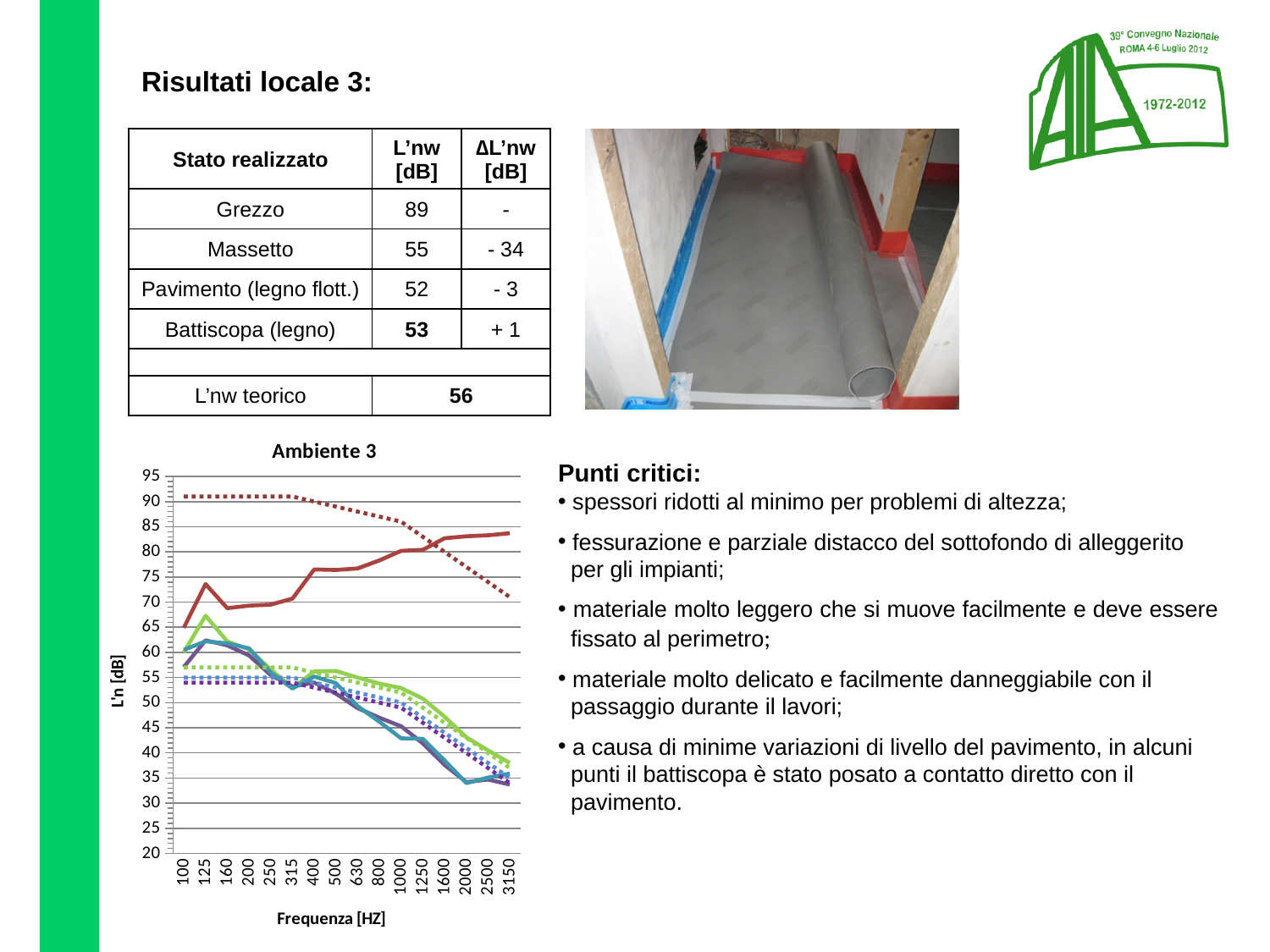
What is the label of the x axis of the chart? Frequenza [HZ] Does the solid green line in the chart rise or fall as frequency increases from 100 Hz to 3150 Hz? fall How many frequency values are shown along the x axis of the chart? 16 What kind of chart is shown on the slide? line chart At 100 Hz, which is higher: the dotted red line or the solid red line? the dotted red line Is the value of the dotted red line at 3150 Hz greater or less than 75? less Does the solid red line in the chart rise or fall as frequency increases from 100 Hz to 3150 Hz? rise What is the title of the chart on the slide? Ambiente 3 Does the dotted red line in the chart rise or fall as frequency increases from 100 Hz to 3150 Hz? fall Is the value of the solid red line at 3150 Hz greater or less than 80? greater Is the value of the solid blue line at 2000 Hz greater or less than 40? less